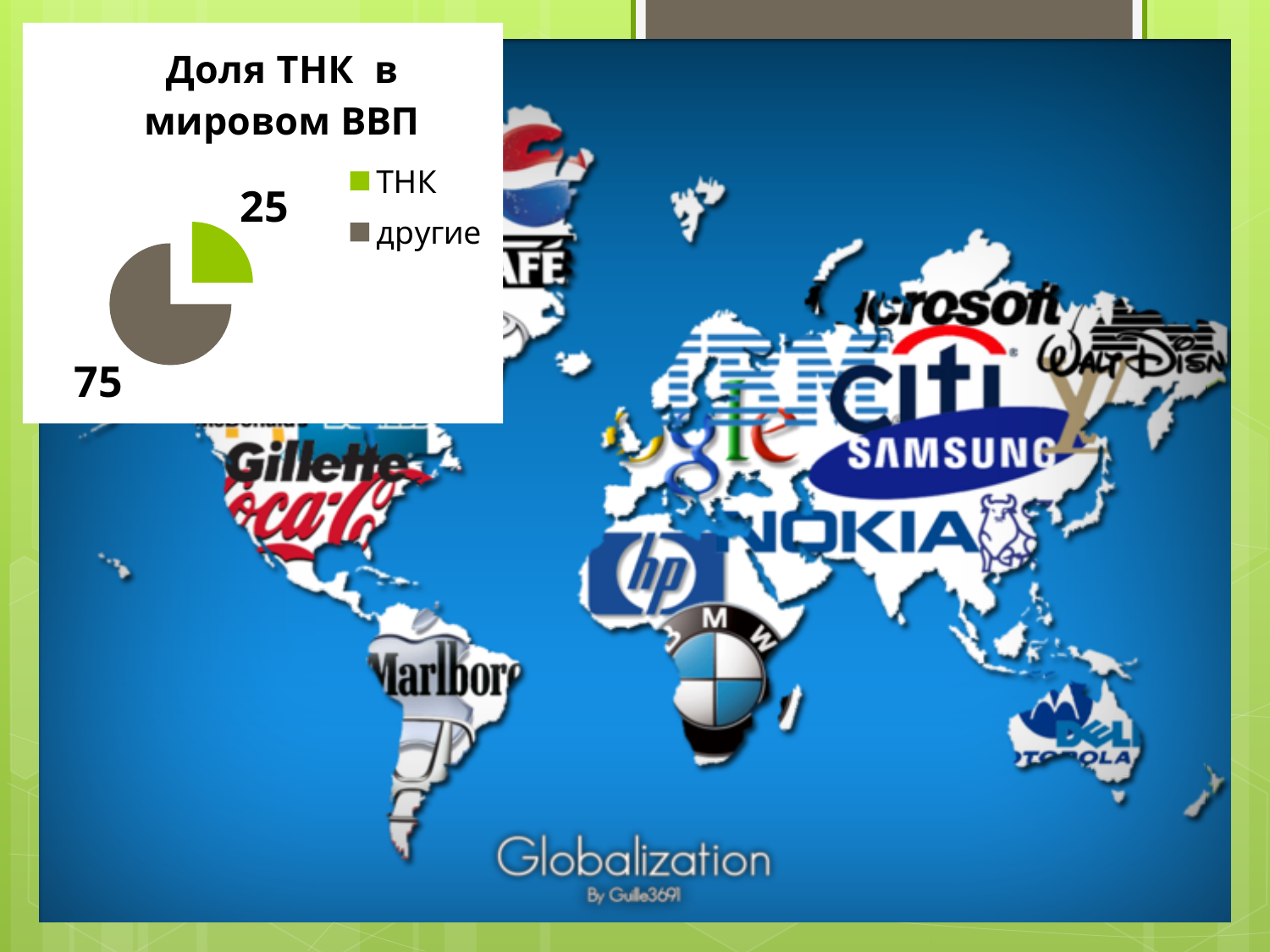
Which is larger, the value for ТНК or the value for другие? другие What is the value for ТНК in the pie chart? 25 What is the value for другие in the pie chart? 75 What kind of chart is shown on the slide? pie chart How many slices does the pie chart have? 2 What colour is the ТНК slice in the pie chart? green What is the title of the chart? Доля ТНК в мировом ВВП What share of the pie does the ТНК slice represent? 25% Which category has the smallest slice in the pie chart? ТНК How many entries does the legend list? 2 Which category has the largest slice in the pie chart? другие What is the difference between the values for другие and ТНК? 50